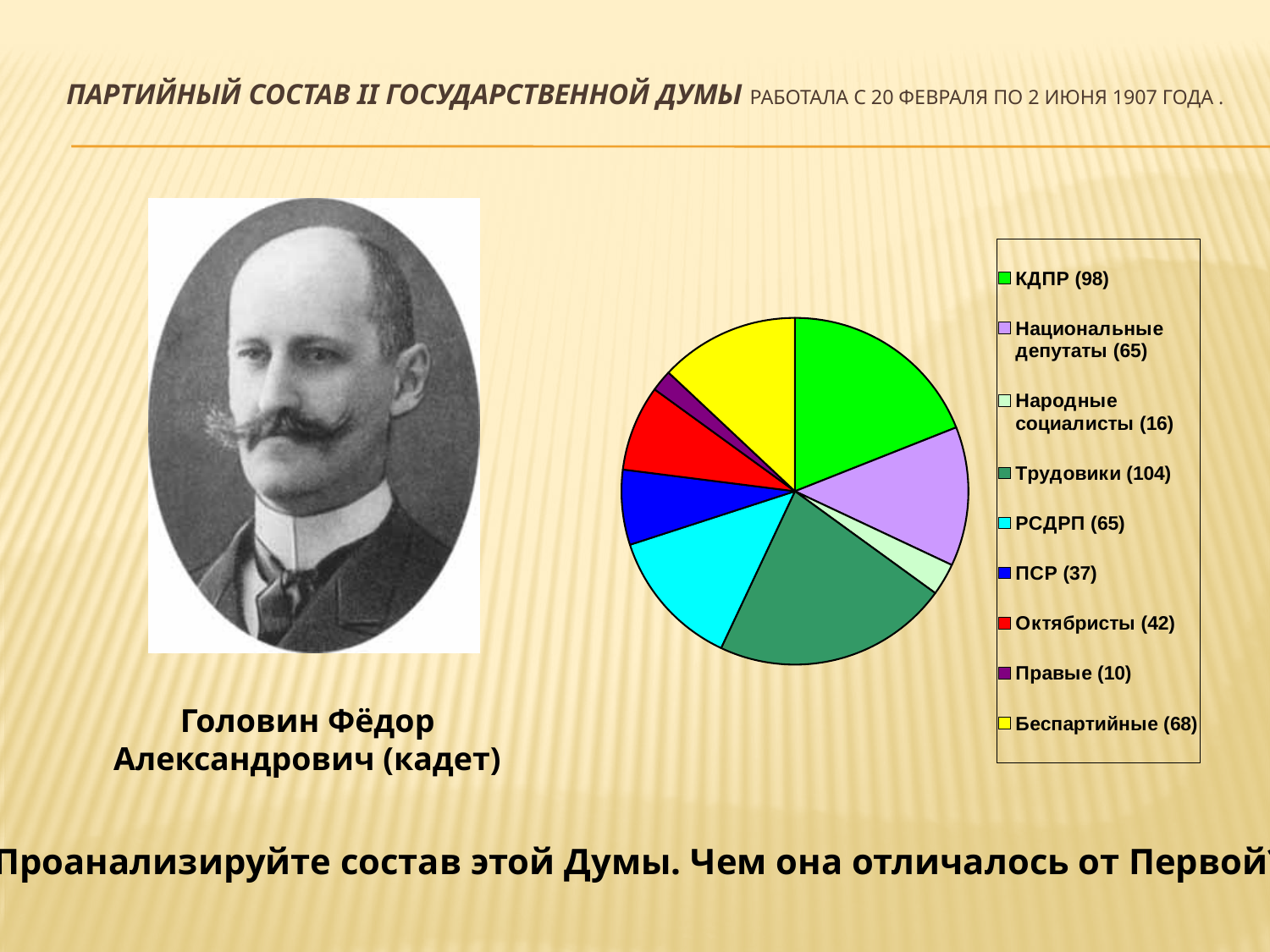
Which party has the smallest number of deputies in the pie chart? Правые (10) What is the difference between the values for Трудовики and КДПР? 6 What is the value shown for Народные социалисты? 16 How many parties (categories) does the pie chart show? 9 What is the value shown for Беспартийные? 68 Which two parties have the same value of 65 in the legend? Национальные депутаты and РСДРП What colour is the slice for КДПР? green What is the value shown for Трудовики in the legend? 104 Which party has the largest number of deputies in the pie chart? Трудовики (104) What is the value shown for КДПР? 98 Which is larger, the value for Октябристы or the value for ПСР? Октябристы What type of chart is shown on the slide? pie chart